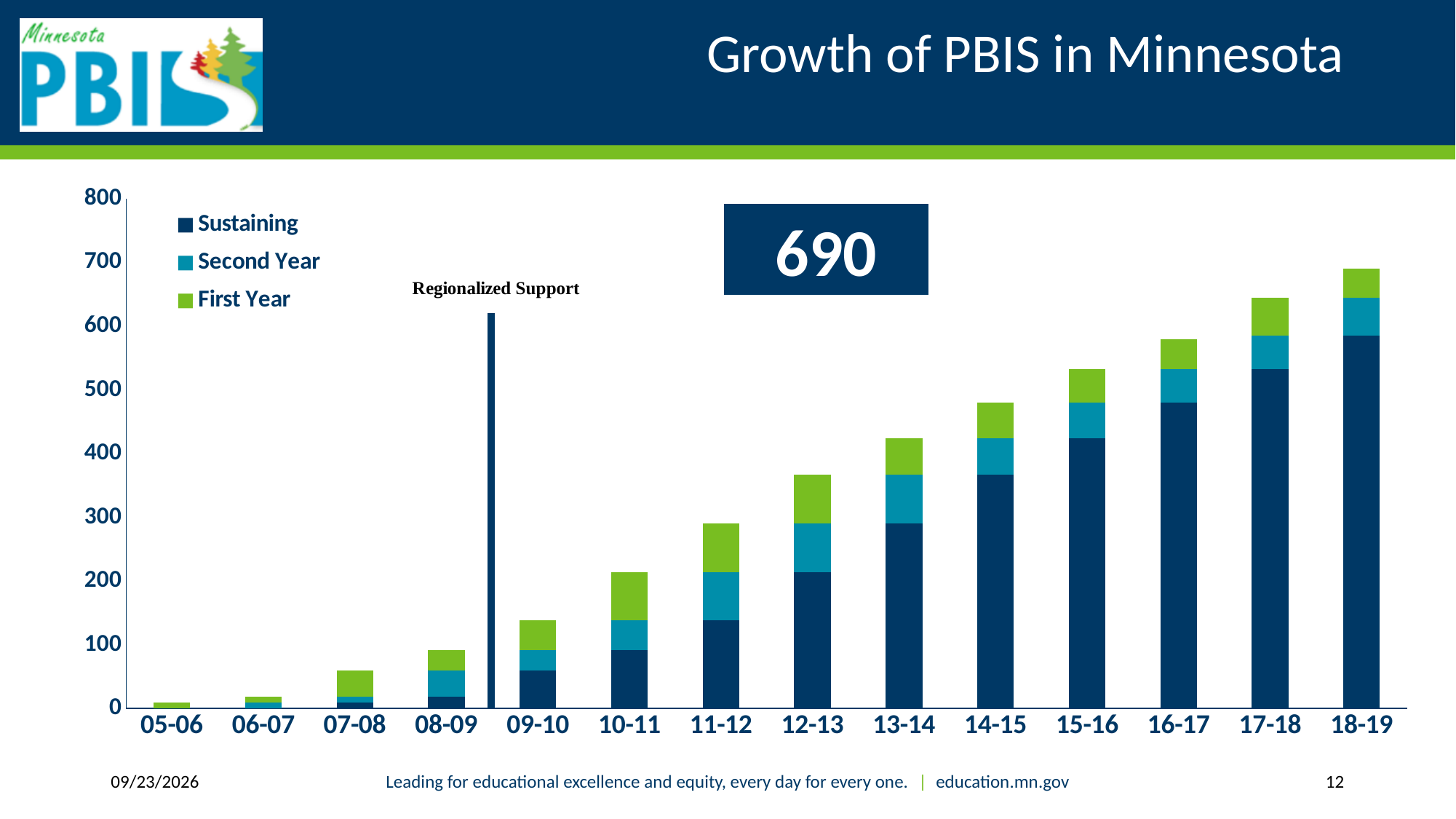
Is the Sustaining value for 18-19 greater or less than 600? less How many school-year categories are shown on the x axis? 14 Which school year has the shortest stacked bar? 05-06 What kind of chart is shown on the slide? Stacked bar chart Is the total stacked value for 16-17 greater or less than 600? less Do the stacked bar totals rise or fall from 05-06 to 18-19? Rise Which has the larger total stacked bar, 12-13 or 13-14? 13-14 How many series does the legend list? 3 What number is displayed in the highlighted box above the chart? 690 Which school year has the tallest stacked bar? 18-19 What text labels the vertical line between 08-09 and 09-10? Regionalized Support Is the total stacked value for 17-18 greater or less than 600? greater